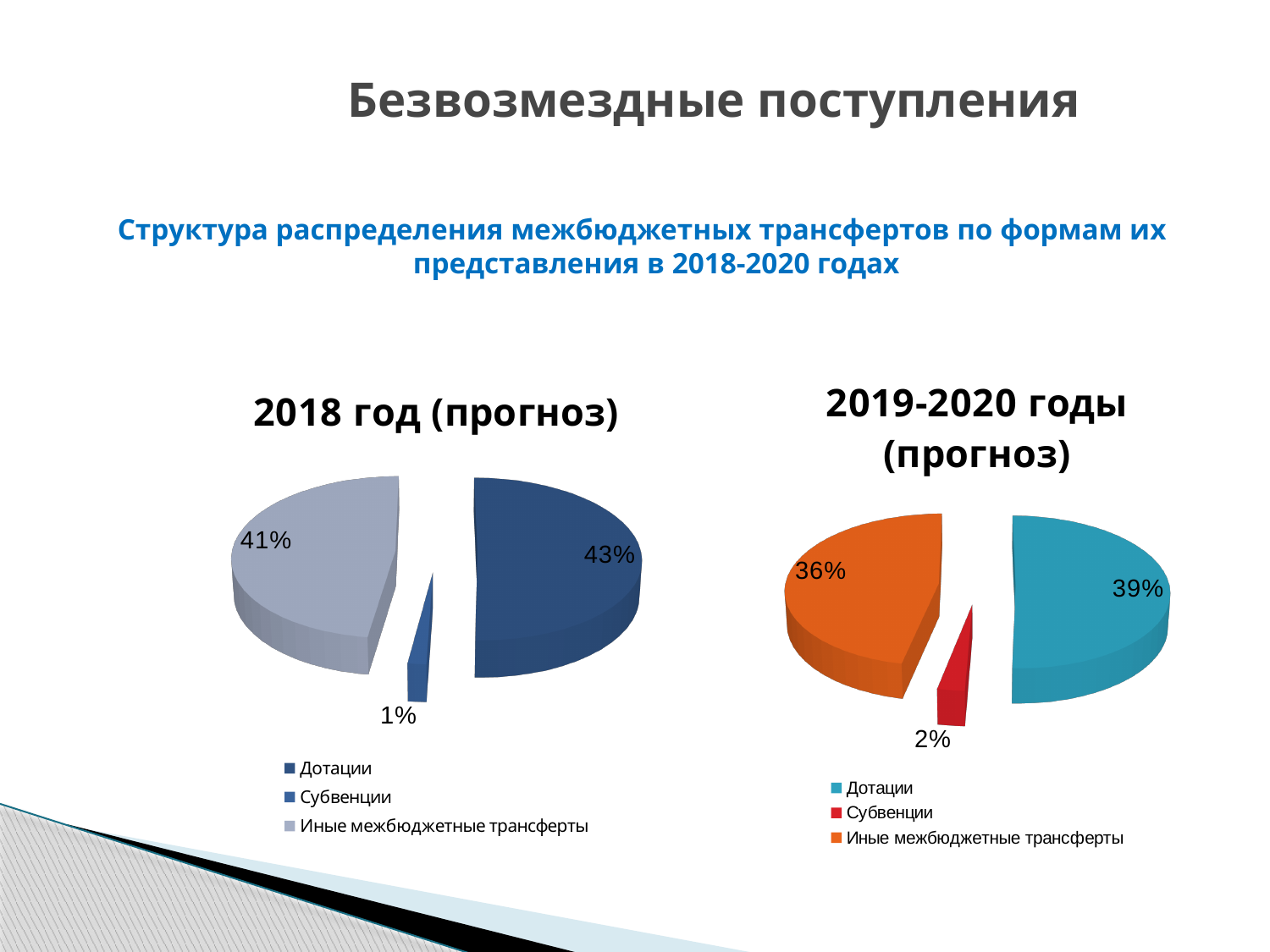
Which is larger: the share for Дотации in the "2018 год (прогноз)" chart or in the "2019-2020 годы (прогноз)" chart? 2018 год (прогноз) In the "2018 год (прогноз)" chart, what share is shown for Субвенции? 1% In the "2019-2020 годы (прогноз)" chart, what share is shown for Дотации? 39% What type of chart is the "2019-2020 годы (прогноз)" chart? Pie chart In the "2018 год (прогноз)" chart, which category has the smallest slice? Субвенции In the "2019-2020 годы (прогноз)" chart, what share is shown for Иные межбюджетные трансферты? 36% In the "2019-2020 годы (прогноз)" chart, which category has the largest slice? Дотации In the "2018 год (прогноз)" chart, what is the difference between the shares for Дотации and Иные межбюджетные трансферты? 2% In the "2019-2020 годы (прогноз)" chart, what share is shown for Субвенции? 2% In the "2018 год (прогноз)" chart, what share is shown for Дотации? 43% In the "2018 год (прогноз)" chart, what share is shown for Иные межбюджетные трансферты? 41% How many categories does the legend of the "2018 год (прогноз)" chart list? 3